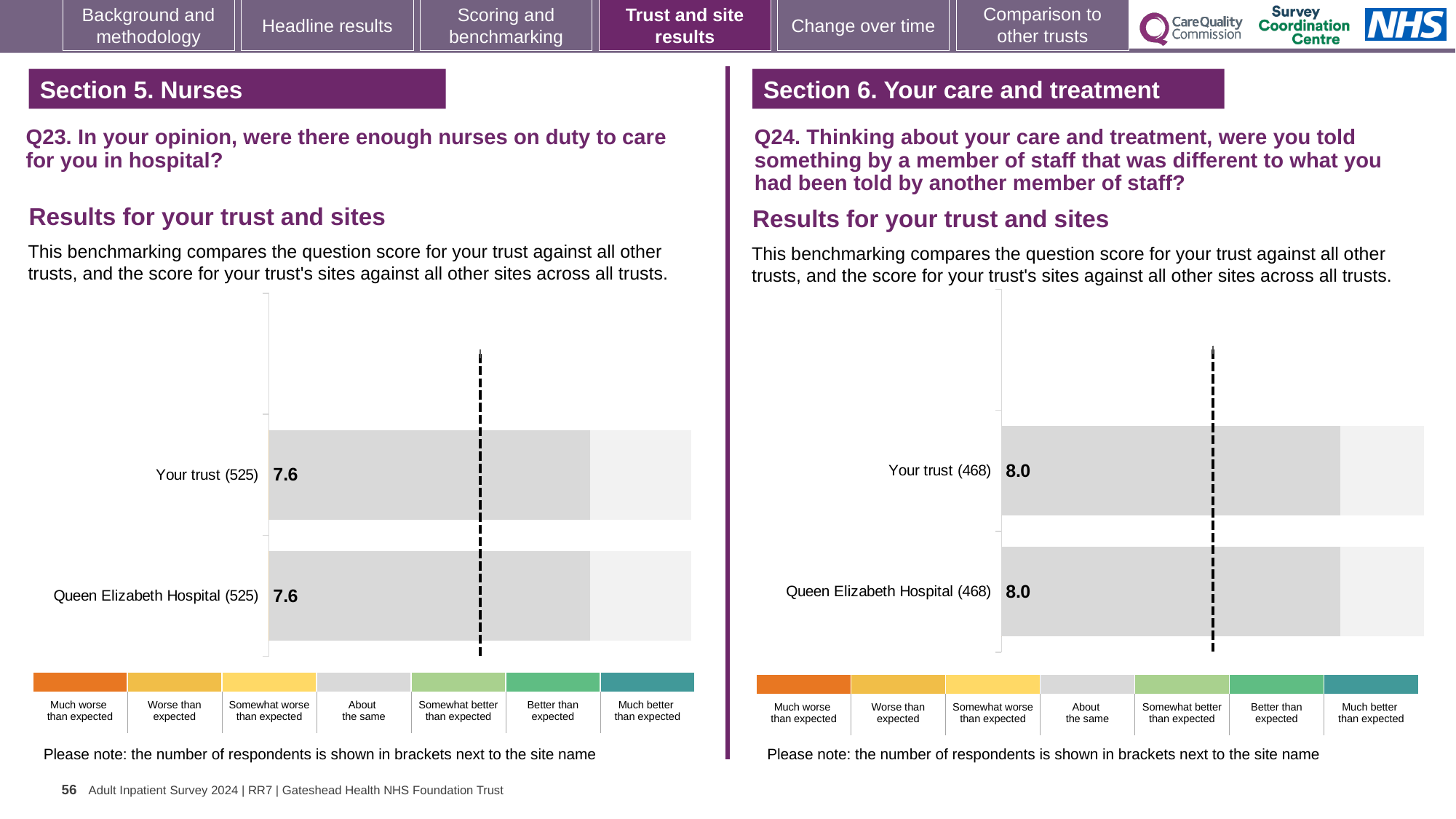
How many bars are plotted in the Q24 chart on the right? 2 In the Q24 chart on the right, how many respondents are shown in brackets next to Queen Elizabeth Hospital? 468 In the Q24 chart on the right, what is the score for Your trust? 8.0 In the Q23 chart on the left, how many respondents are shown in brackets next to Your trust? 525 In the Q23 chart on the left, what is the difference between the score for Your trust and the score for Queen Elizabeth Hospital? 0.0 What kind of chart is used for the Q23 results on the left? Bar chart In the Q24 chart on the right, what is the score for Queen Elizabeth Hospital? 8.0 In the Q23 chart on the left, what is the score for Queen Elizabeth Hospital? 7.6 How many bars are plotted in the Q23 chart on the left? 2 In the Q24 chart on the right, what is the difference between the score for Your trust and the score for Queen Elizabeth Hospital? 0.0 In the Q23 chart on the left, what is the score for Your trust? 7.6